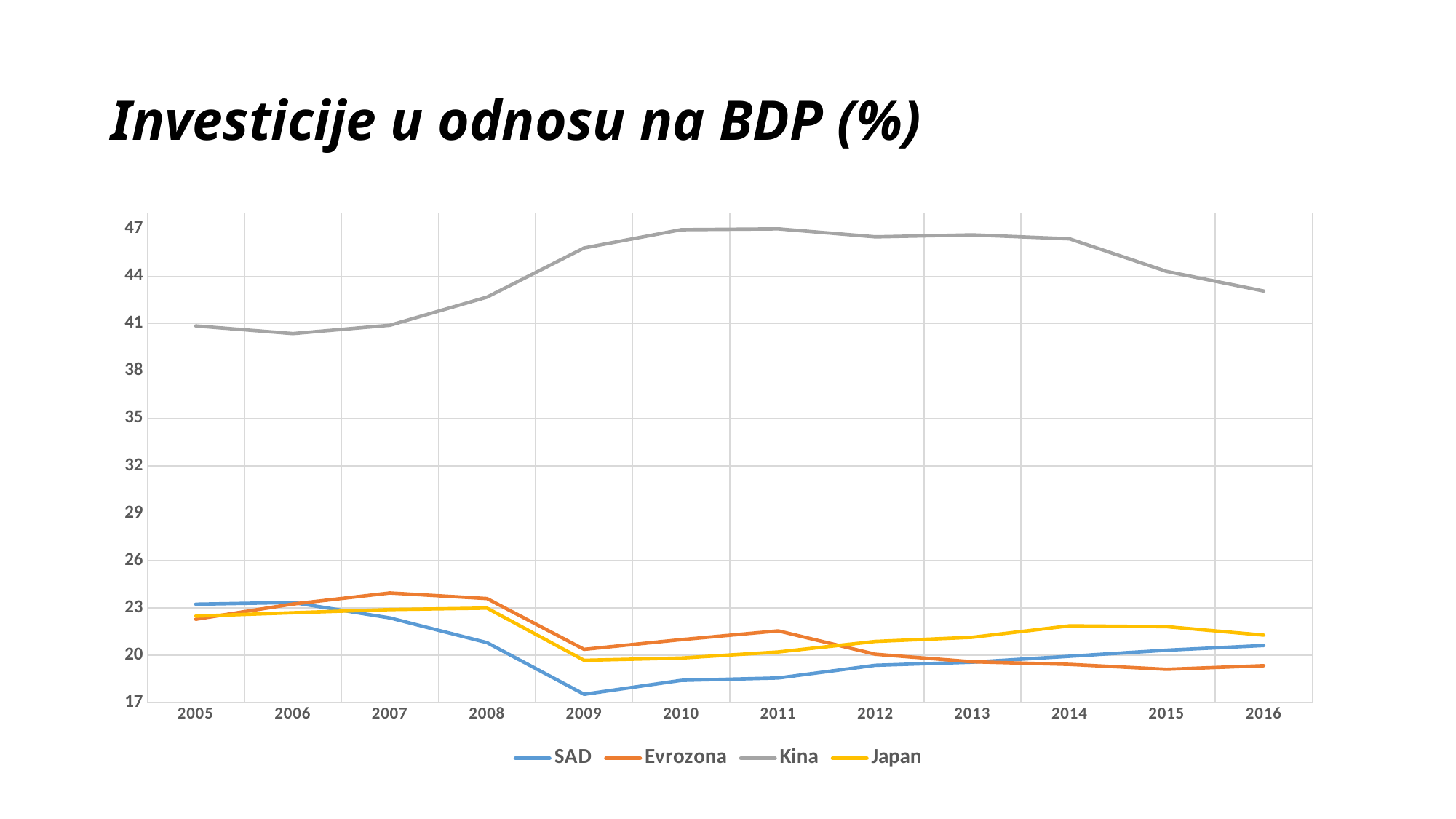
Is the value for SAD in 2009 greater or less than 20? less How many years are shown on the x axis? 12 Is the value for Evrozona in 2007 greater or less than 23? greater What kind of chart is shown on the slide? line chart In 2016, which is higher: Japan or Evrozona? Japan Is the value for Kina in 2010 greater or less than 44? greater Which series has the highest values across all years? Kina Does the Kina line rise or fall from 2011 to 2016? fall What is the title of the slide? Investicije u odnosu na BDP (%) Which series has the lowest value in 2016? Evrozona How many series does the legend list? 4 Which series has the lowest value in 2009? SAD